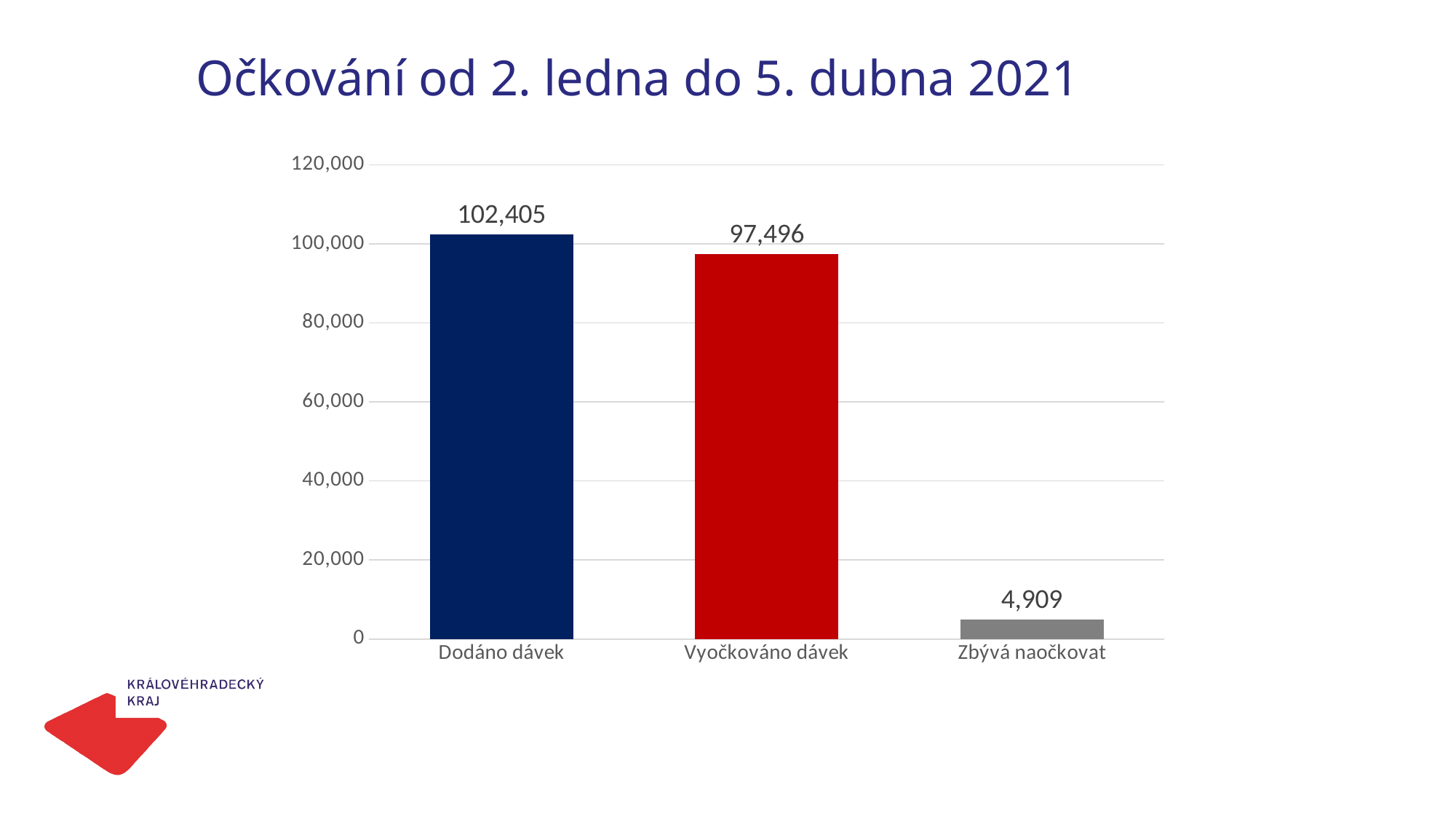
What is the value for Vyočkováno dávek? 97,496 What is the value for Zbývá naočkovat? 4,909 What is the title of the chart? Očkování od 2. ledna do 5. dubna 2021 What is the difference between Vyočkováno dávek and Zbývá naočkovat? 92,587 What kind of chart is shown on the slide? bar chart Which category has the lowest value? Zbývá naočkovat Is the value for Vyočkováno dávek greater or less than 100,000? less Which is larger, Dodáno dávek or Vyočkováno dávek? Dodáno dávek How many categories are shown in the chart? 3 What is the difference between Dodáno dávek and Vyočkováno dávek? 4,909 Which category has the highest value? Dodáno dávek What is the value for Dodáno dávek? 102,405